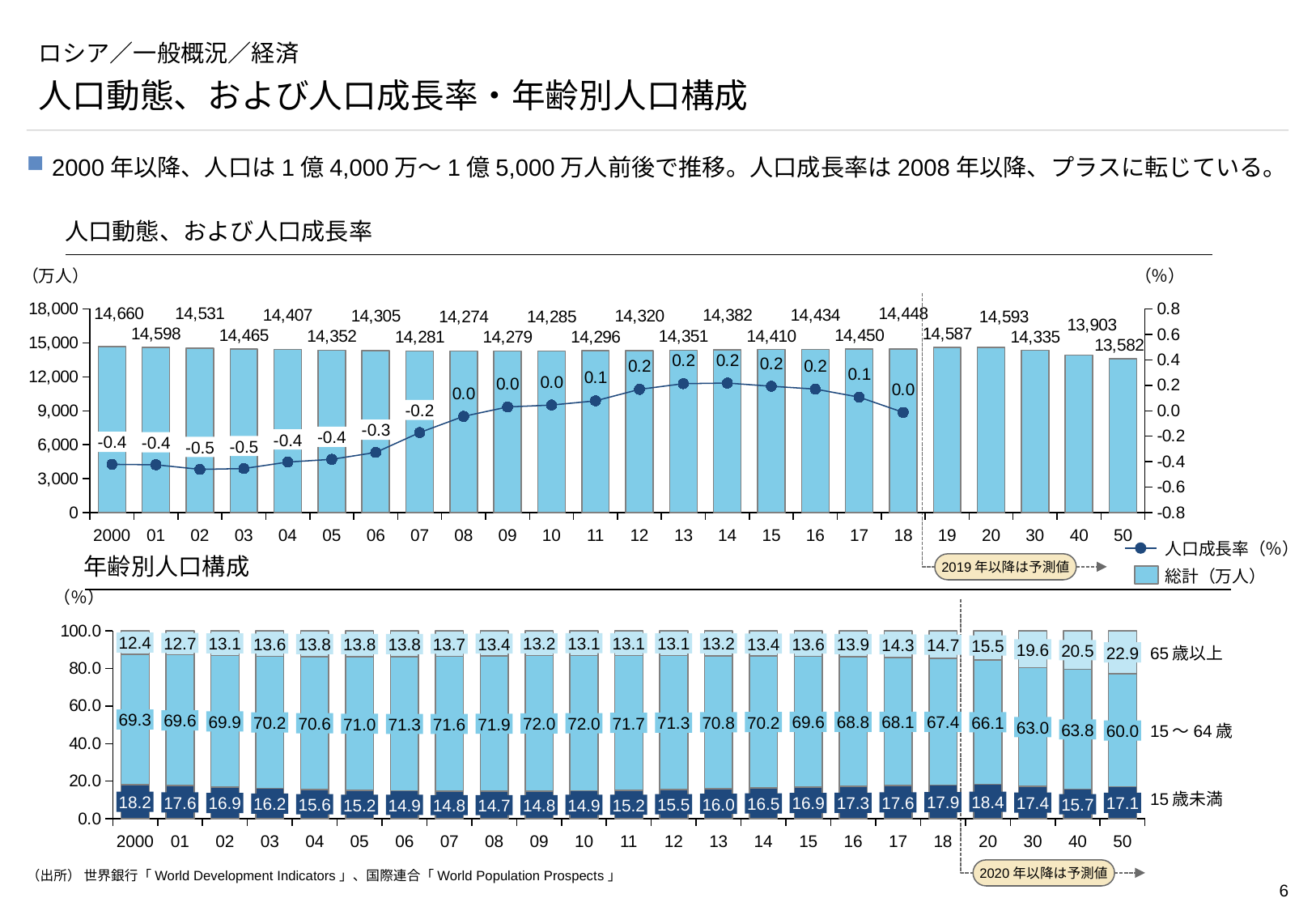
In the bottom chart (年齢別人口構成), how many categories are shown on the x axis? 23 In the bottom chart (年齢別人口構成), which year has the highest 15～64歳 value? 09 and 10 (72.0) In the top chart (人口動態、および人口成長率), which is larger, the 総計 value for 19 or for 40? 19 In the top chart (人口動態、および人口成長率), which year has the lowest 総計 value? 50 In the bottom chart (年齢別人口構成), what is the 65歳以上 share for 50? 22.9 In the top chart (人口動態、および人口成長率), what is the 人口成長率 value for 2012? 0.2 What kind of chart is the bottom chart (年齢別人口構成)? Stacked bar chart In the bottom chart (年齢別人口構成), what is the difference between the 65歳以上 values for 50 and 2000? 10.5 In the top chart (人口動態、および人口成長率), what is the 総計 value for 2000? 14,660 In the bottom chart (年齢別人口構成), what is the 15歳未満 value for 2000? 18.2 In the top chart (人口動態、および人口成長率), what is the difference between the 総計 values for 2000 and 08? 386 In the top chart (人口動態、および人口成長率), how many series does the legend list? 2